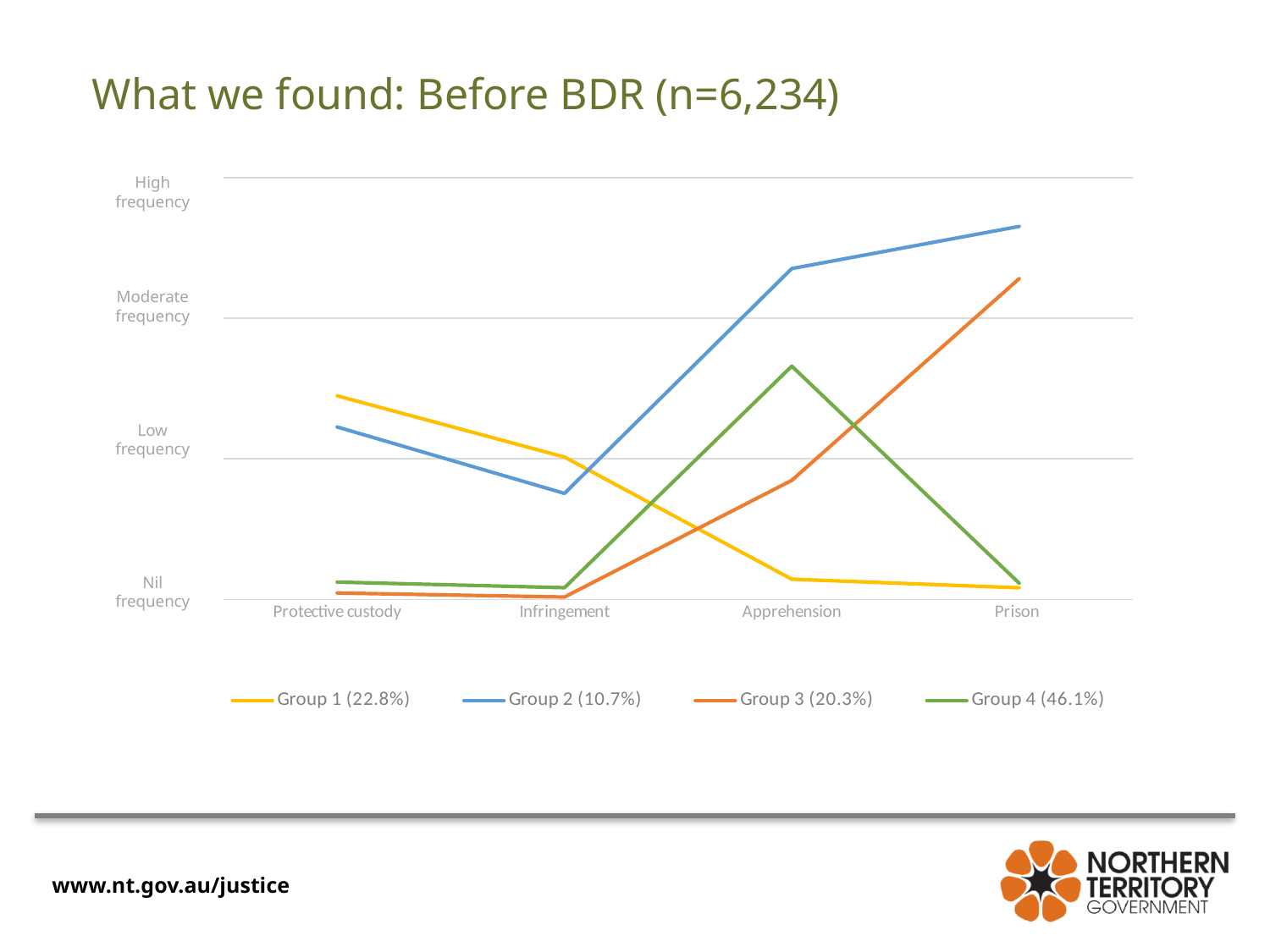
What is the title of the slide? What we found: Before BDR (n=6,234) Which group has the lowest value at Apprehension? Group 1 (22.8%) At Infringement, which is higher: Group 1 (22.8%) or Group 2 (10.7%)? Group 1 (22.8%) What percentage is shown in the legend for Group 4? 46.1% Does the line for Group 1 (22.8%) rise or fall from Protective custody to Prison? fall Which group has the highest value at Protective custody? Group 1 (22.8%) Is the value for Group 2 (10.7%) at Prison greater or less than Moderate frequency? greater How many categories are shown along the x axis? 4 Which group has the highest value at Prison? Group 2 (10.7%) How many series does the legend list? 4 Which group has the highest value at Apprehension? Group 2 (10.7%) What kind of chart is shown on the slide? line chart